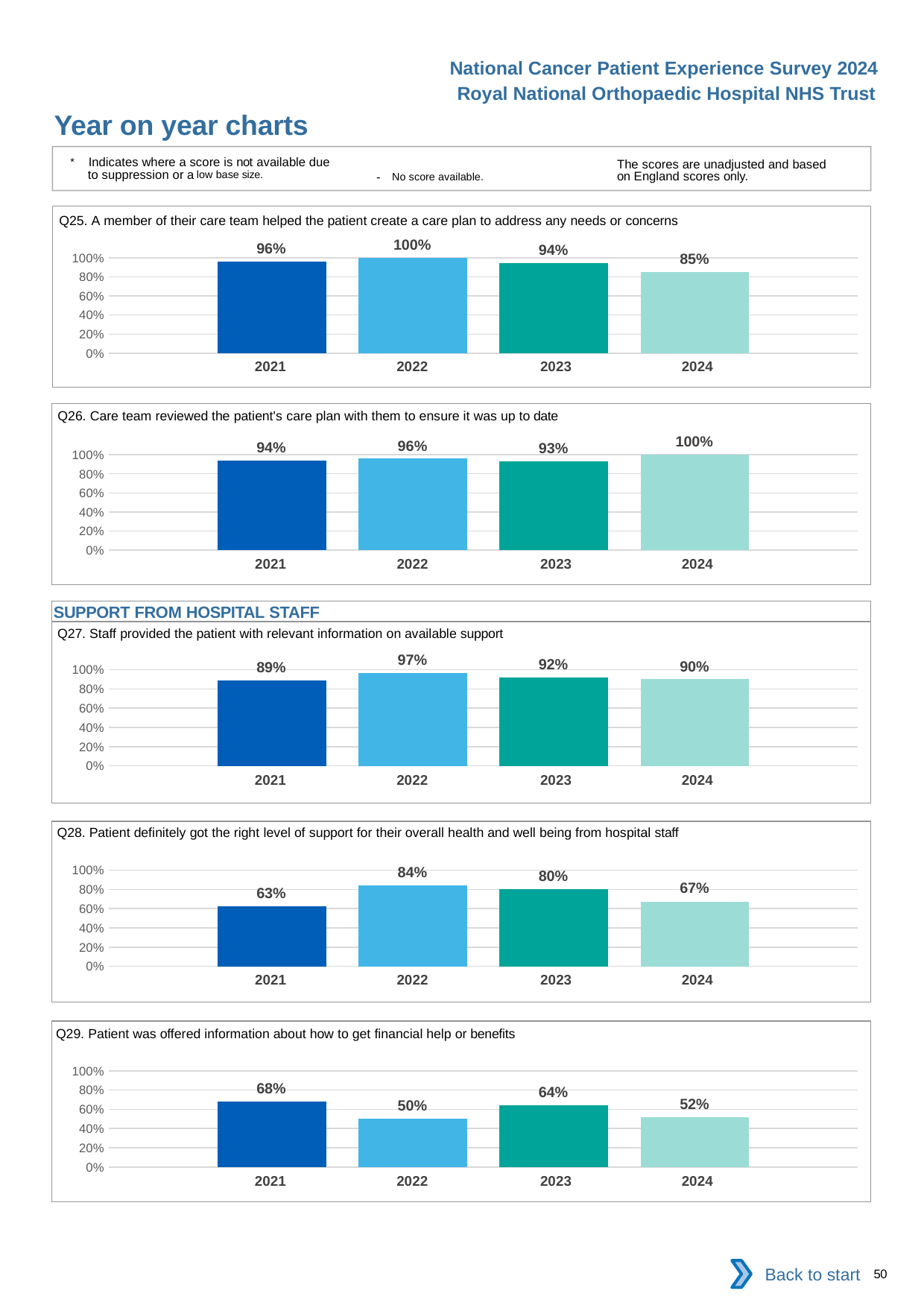
In the Q26 chart, what is the difference between the 2022 and 2023 values? 3% In the Q29 chart, which year has the lowest value? 2022 How many years are shown in the Q29 chart? 4 In the Q28 chart, which is larger, the value for 2021 or the value for 2024? 2024 What kind of chart is the Q28 chart? bar chart In the Q27 chart, what is the value for 2021? 89% In the Q25 chart, which year has the lowest value? 2024 In the Q25 chart, what is the value for 2022? 100% In the Q26 chart, what is the value for 2024? 100% In the Q29 chart, what is the value for 2023? 64% In the Q28 chart, what is the difference between the 2022 and 2021 values? 21% In the Q27 chart, which year has the highest value? 2022